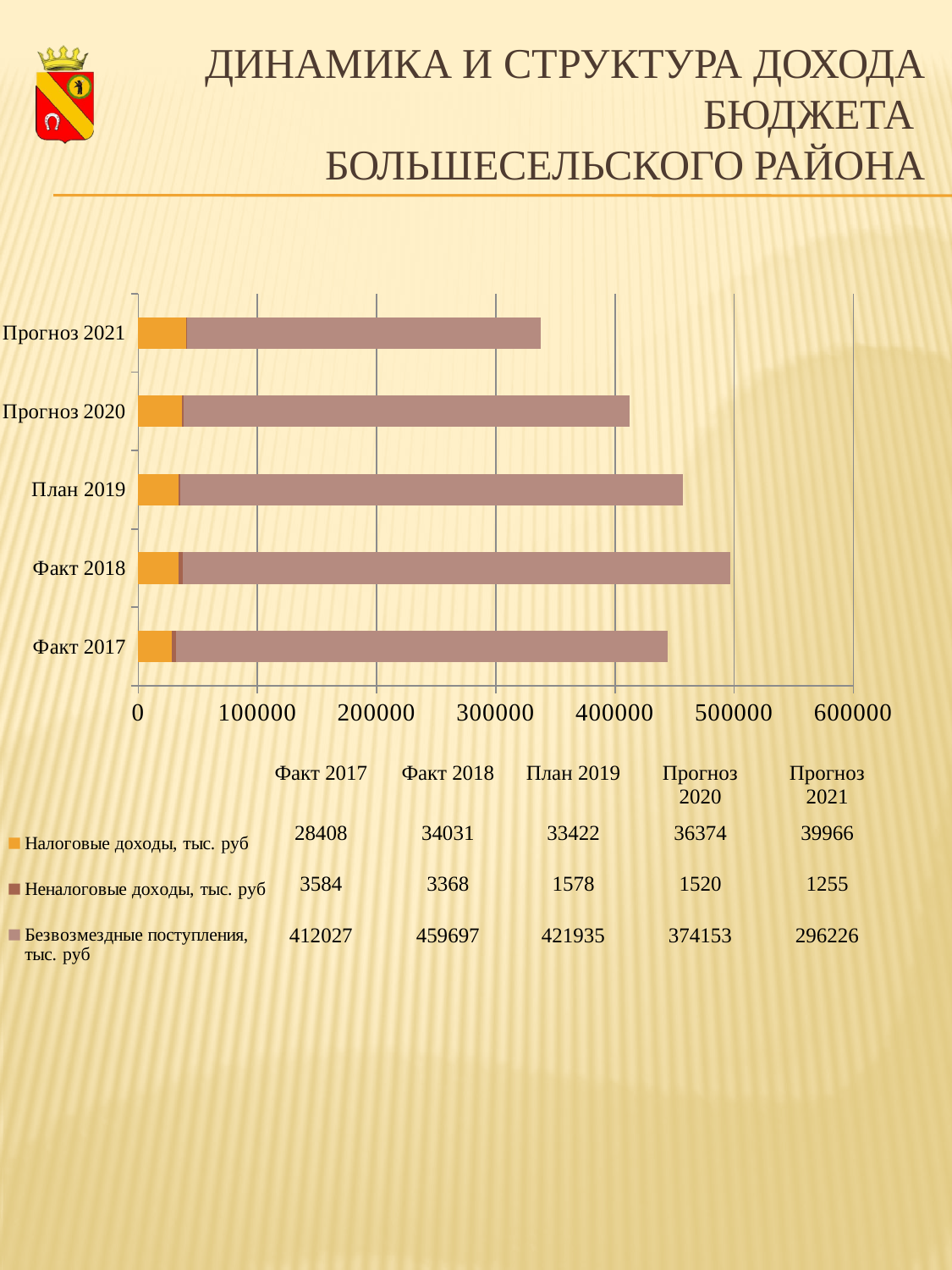
What is the value of Налоговые доходы, тыс. руб for Факт 2017? 28408 What is the value of Безвозмездные поступления, тыс. руб for План 2019? 421935 What is the value of Неналоговые доходы, тыс. руб for Прогноз 2020? 1520 Which is larger: Налоговые доходы, тыс. руб for Прогноз 2021 or for Факт 2017? Прогноз 2021 How many categories are shown on the vertical axis of the chart? 5 Which category has the lowest value for Неналоговые доходы, тыс. руб? Прогноз 2021 Is the total length of the Прогноз 2021 bar greater or less than 400000? less What is the total of the stacked bar for Факт 2018? 497096 Which category has the highest value for Безвозмездные поступления, тыс. руб? Факт 2018 What kind of chart is shown on the slide? stacked bar chart What is the difference between Безвозмездные поступления, тыс. руб for Факт 2018 and Факт 2017? 47670 How many series does the legend list? 3